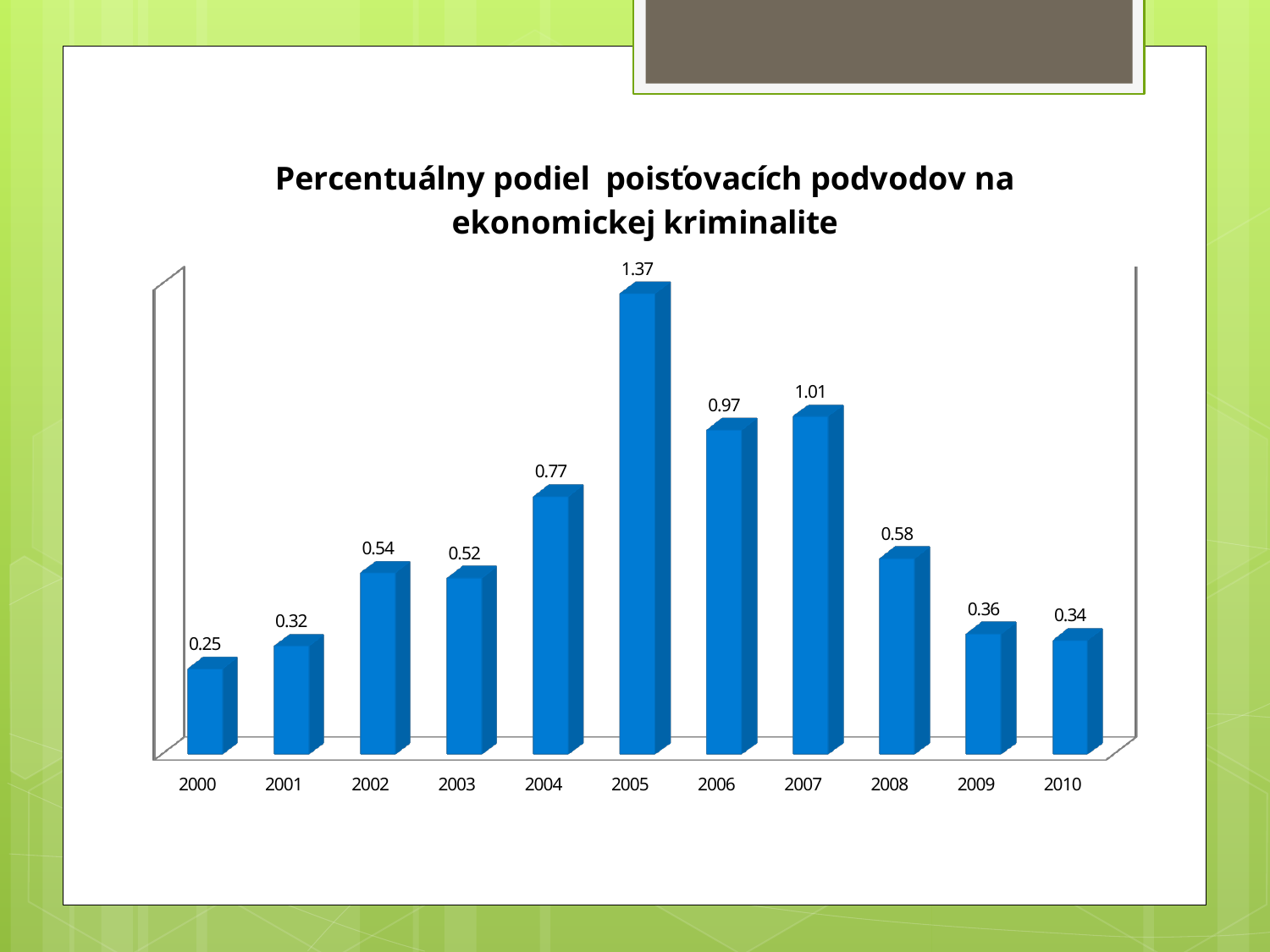
What is the value for 2005? 1.37 What is the value for 2008? 0.58 How many years are shown on the x axis? 11 Which is larger, the value for 2006 or the value for 2007? 2007 What is the value for 2000? 0.25 What is the difference between the values for 2007 and 2008? 0.43 Which is larger, the value for 2002 or the value for 2003? 2002 Which year has the highest value? 2005 What is the difference between the values for 2005 and 2006? 0.40 What kind of chart is shown on the slide? bar chart Do the values rise or fall from 2005 to 2010? fall Which year has the lowest value? 2000